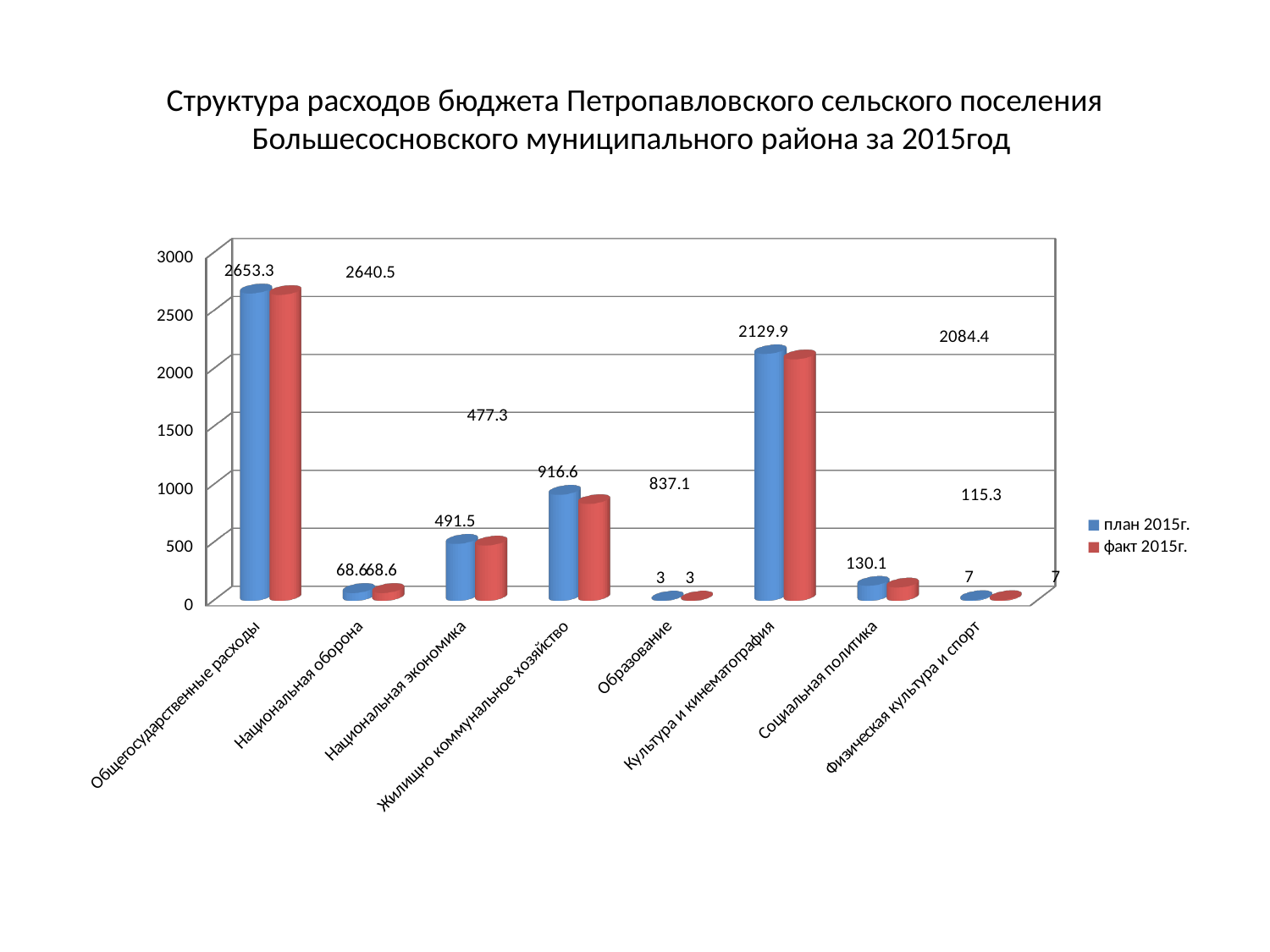
What is the план 2015г. value for Социальная политика? 130.1 Which category has the lowest факт 2015г. value? Образование How many series does the legend list? 2 Is the план 2015г. value for Жилищно коммунальное хозяйство greater or less than 500? greater What is the факт 2015г. value for Жилищно коммунальное хозяйство? 837.1 What is the факт 2015г. value for Культура и кинематография? 2084.4 What is the difference between the план 2015г. and факт 2015г. values for Национальная экономика? 14.2 Which is larger for Культура и кинематография: the план 2015г. value or the факт 2015г. value? план 2015г. What is the план 2015г. value for Общегосударственные расходы? 2653.3 Which category has the highest план 2015г. value? Общегосударственные расходы How many categories are shown on the x axis? 8 What kind of chart is shown on the slide? bar chart